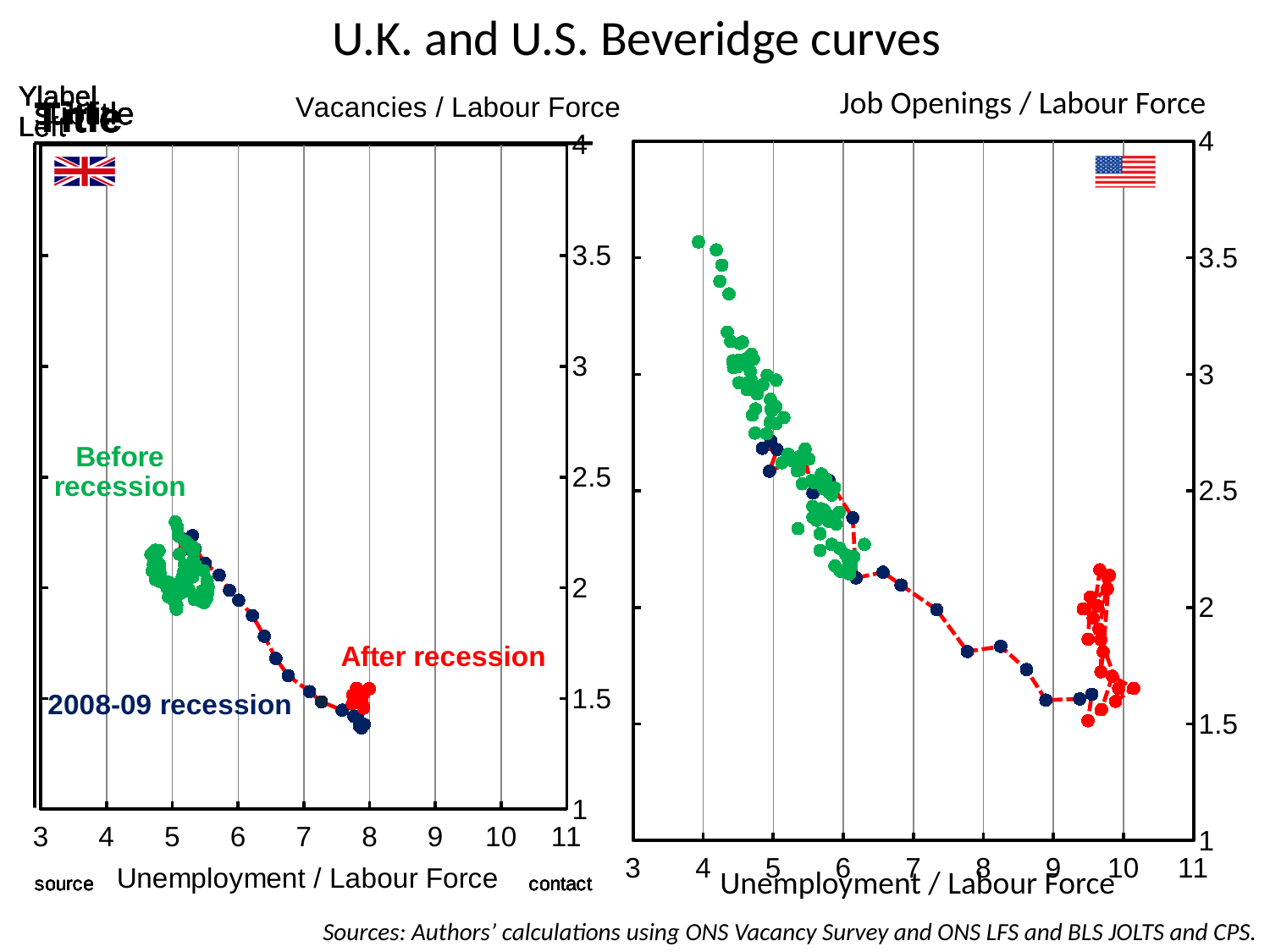
On the left chart (Vacancies / Labour Force), are the unemployment values of the green 'Before recession' points greater or less than 6? less On the left chart (Vacancies / Labour Force), as unemployment increases along the x axis, do the vacancy values rise or fall? Fall What is the x-axis label on the right chart (Job Openings / Labour Force)? Unemployment / Labour Force On the left chart (Vacancies / Labour Force), are the vacancy values of the red 'After recession' points greater or less than 2? less On the left chart (Vacancies / Labour Force), which group has higher unemployment values, the green 'Before recession' points or the red 'After recession' points? Red 'After recession' points On the right chart (Job Openings / Labour Force), as unemployment increases along the x axis, do the job openings values rise or fall? Fall On the right chart (Job Openings / Labour Force), is the lowest job openings value among the dark blue points greater or less than 2? less On the right chart (Job Openings / Labour Force), which group of points has higher job openings values, the green points or the red points? Green points What is the title of the slide? U.K. and U.S. Beveridge curves What kind of chart is the left chart (Vacancies / Labour Force)? Scatter chart